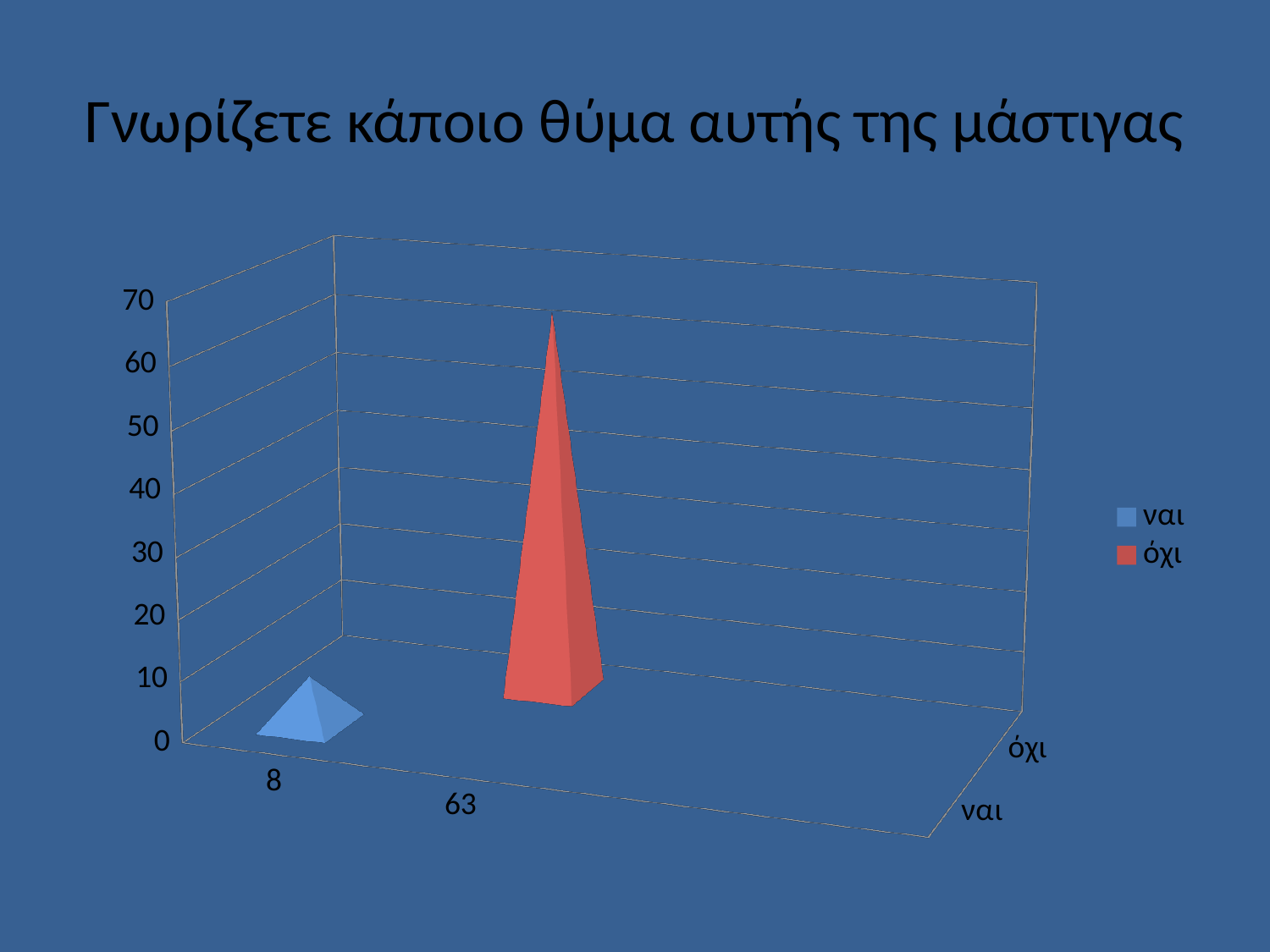
How many categories are labelled along the x axis? 2 What are the two entries in the legend? ναι and όχι Which is larger, the value for ναι or the value for όχι? όχι What kind of chart is shown on the slide? bar chart Which series has the shortest bar? ναι Is the value for όχι greater or less than 50? greater Is the value for ναι greater or less than 40? less How many series does the legend list? 2 Is the value for ναι greater or less than 20? less Which series has the tallest bar? όχι What is the title of the chart? Γνωρίζετε κάποιο θύμα αυτής της μάστιγας